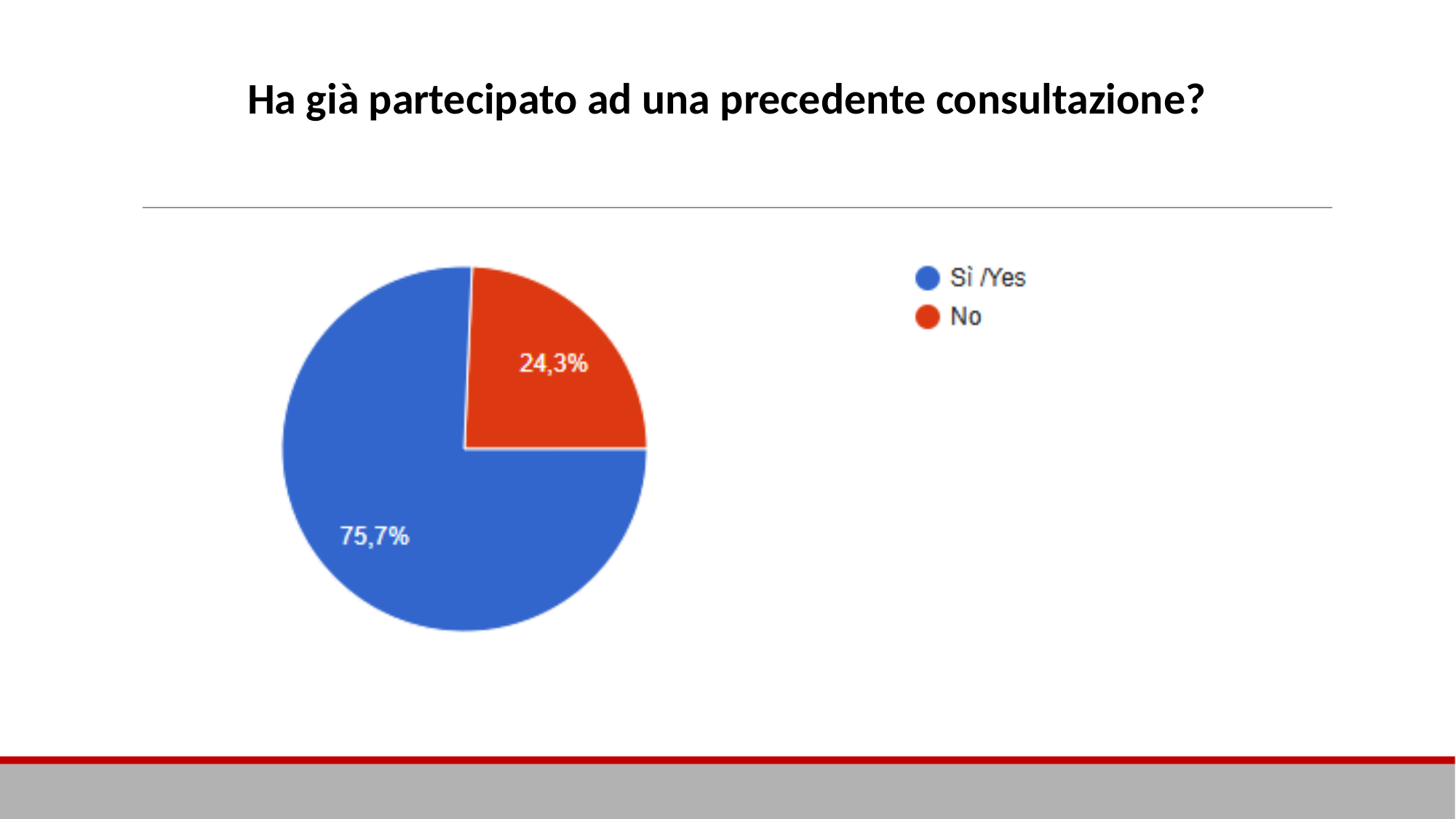
What kind of chart is shown on the slide? Pie chart Which slice of the pie is the largest? Sì /Yes What is the title of the chart on the slide? Ha già partecipato ad una precedente consultazione? What is the difference in percentage points between the "Sì /Yes" slice and the "No" slice? 51,4 What colour is the "No" slice of the pie? Red How many entries does the legend list? 2 Which slice of the pie is the smallest? No What share of the pie is labelled "No"? 24,3% How many slices does the pie chart have? 2 What share of the pie is labelled "Sì /Yes"? 75,7% Which is larger, the "Sì /Yes" slice or the "No" slice? Sì /Yes